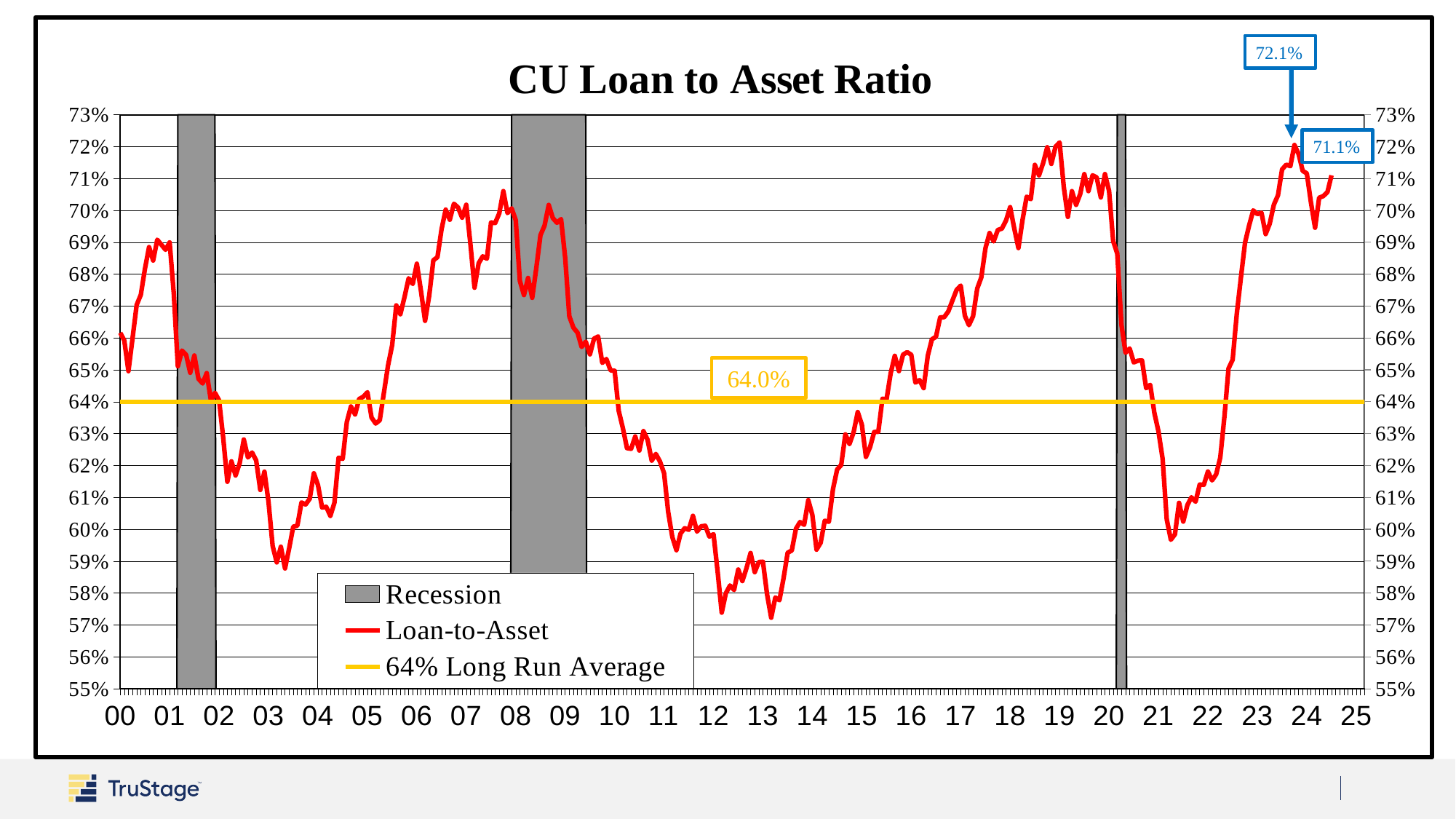
How many recession periods are shaded on the chart? 3 What is the difference between the labelled peak of 72.1% and the latest labelled value of 71.1%? 1.0% Is the Loan-to-Asset value at the start of 2000 greater or less than 65%? greater What is the most recent Loan-to-Asset value labelled at the end of the line? 71.1% What kind of chart is shown on the slide? line chart What is the title of the chart? CU Loan to Asset Ratio What value is labelled on the long run average line? 64.0% Does the Loan-to-Asset line rise or fall between 2021 and 2024? rise How many entries does the chart's legend list? 3 How far above the 64.0% long run average is the labelled peak of 72.1%? 8.1% What is the peak value of the Loan-to-Asset line labelled near 2024? 72.1% Is the lowest Loan-to-Asset value around 2013 greater or less than 58%? less